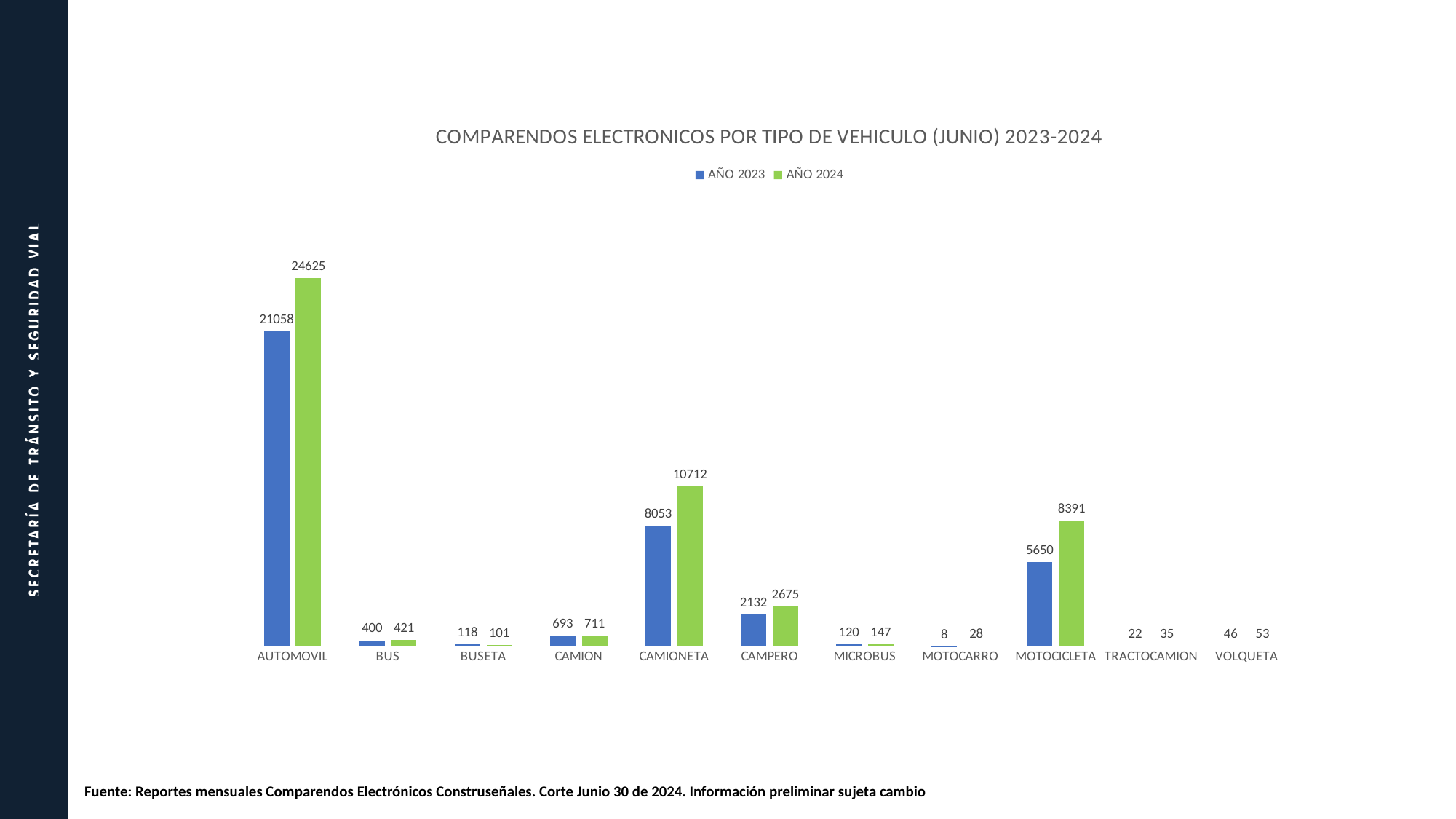
What is the value for AUTOMOVIL in the AÑO 2024 series? 24625 Which is larger for BUSETA: the AÑO 2023 value or the AÑO 2024 value? AÑO 2023 What is the difference between the AÑO 2024 and AÑO 2023 values for CAMIONETA? 2659 How many vehicle categories are shown on the x axis? 11 What is the value for MOTOCICLETA in the AÑO 2023 series? 5650 What is the title of the chart? COMPARENDOS ELECTRONICOS POR TIPO DE VEHICULO (JUNIO) 2023-2024 Which colour represents the AÑO 2024 series? Green Which category has the lowest value in the AÑO 2024 series? MOTOCARRO What is the value for CAMPERO in the AÑO 2024 series? 2675 Which category has the highest value in the AÑO 2023 series? AUTOMOVIL What kind of chart is shown on the slide? Bar chart How many series does the legend list? 2